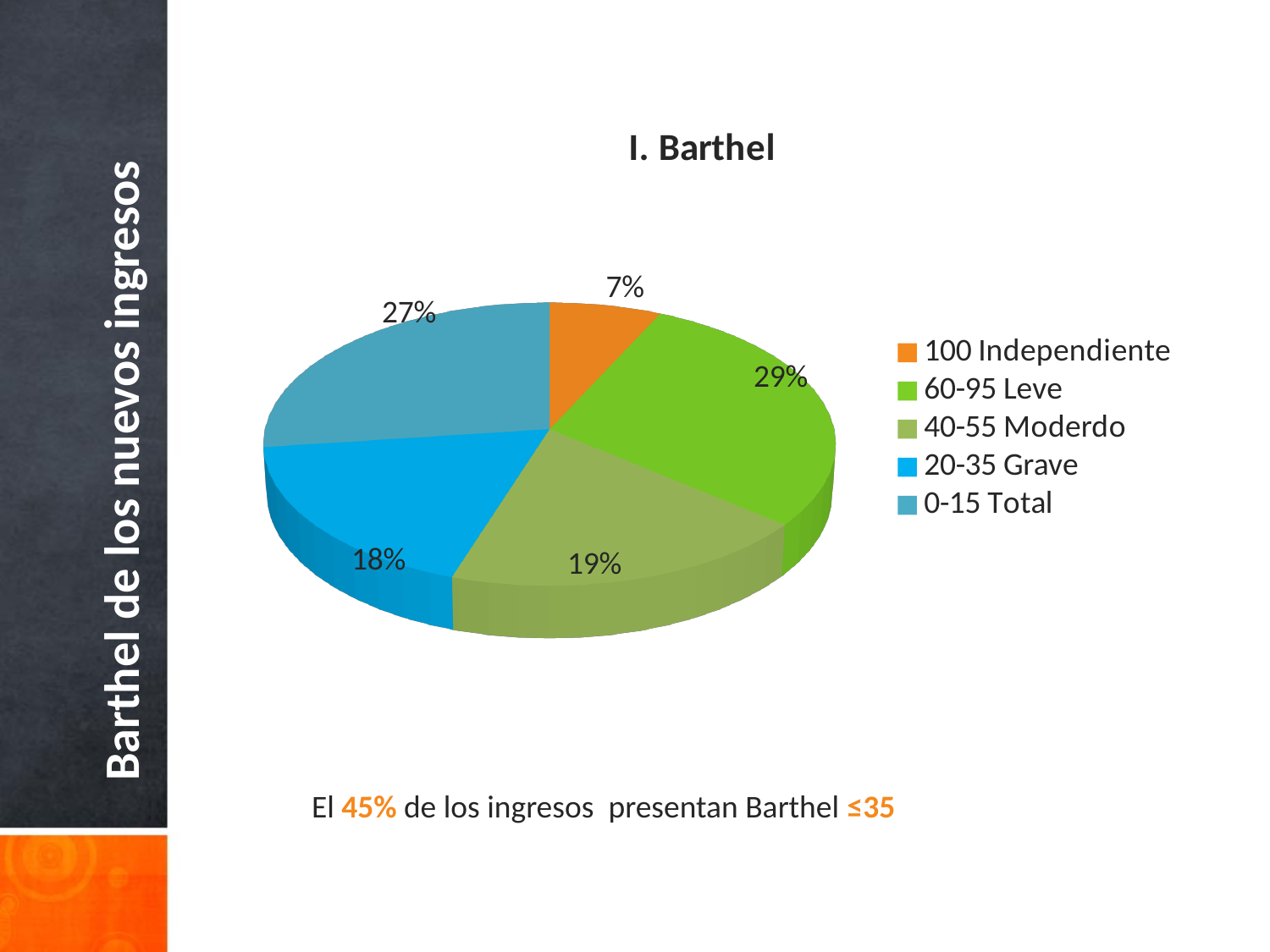
Which is larger, the 0-15 Total slice or the 20-35 Grave slice? 0-15 Total What percentage of the pie is the 40-55 Moderdo slice? 19% What percentage of the pie is the 100 Independiente slice? 7% What percentage of the pie is the 20-35 Grave slice? 18% What percentage of the pie is the 60-95 Leve slice? 29% What is the chart's title? I. Barthel What kind of chart is shown on the slide? Pie chart How many categories does the legend list? 5 What percentage of the pie is the 0-15 Total slice? 27% What is the difference in percentage points between the 60-95 Leve slice and the 0-15 Total slice? 2 Which category has the largest share of the pie? 60-95 Leve Which category has the smallest share of the pie? 100 Independiente